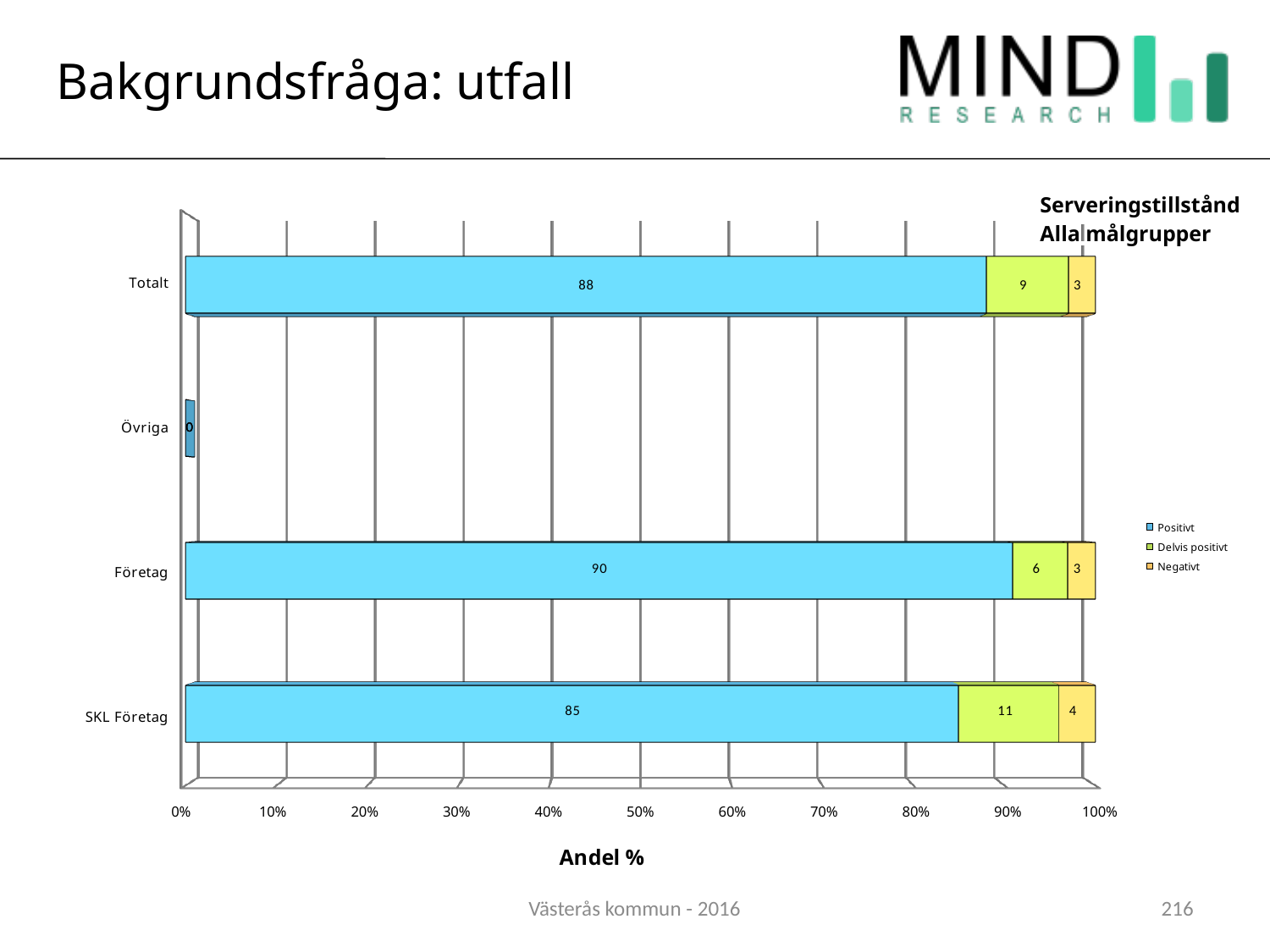
What is the difference between the Positivt values for Företag and SKL Företag? 5 How many series does the legend list? 3 What is the Negativt value for Företag? 3 What is the total of the stacked bar for SKL Företag? 100 What kind of chart is shown on the slide? Stacked bar chart How many categories are shown on the y axis? 4 Which category has the lowest Positivt value? Övriga What is the Positivt value for Övriga? 0 What is the Positivt value for Totalt? 88 What is the Delvis positivt value for SKL Företag? 11 Which is larger, the Delvis positivt value for Totalt or for Företag? Totalt Which category has the highest Positivt value? Företag